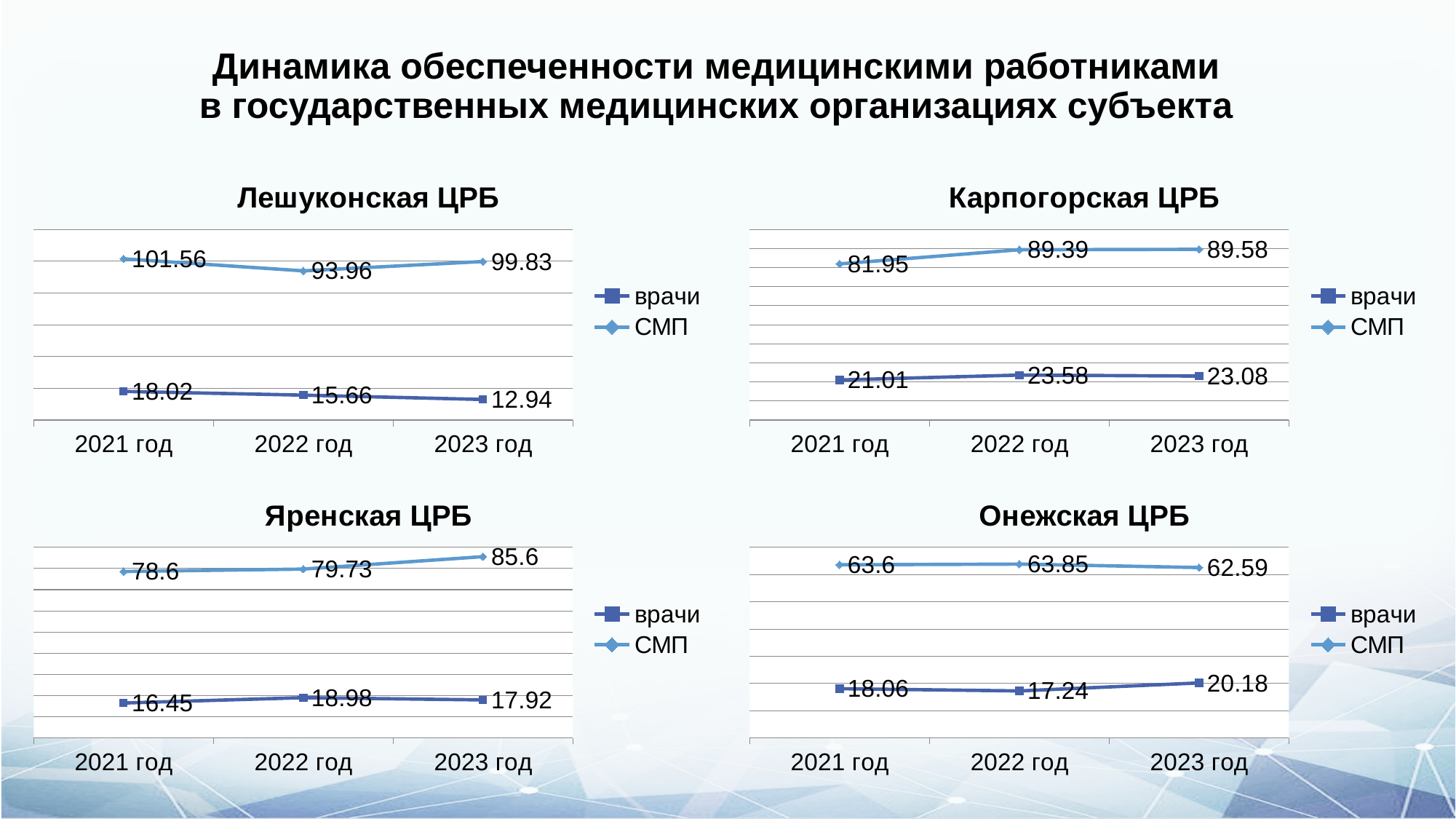
In the Яренская ЦРБ chart, what is the value for СМП in 2023 год? 85.6 In the Лешуконская ЦРБ chart, what is the value for СМП in 2021 год? 101.56 How many years are plotted on the x axis of the Онежская ЦРБ chart? 3 In the Лешуконская ЦРБ chart, do the врачи values rise or fall from 2021 год to 2023 год? fall In the Карпогорская ЦРБ chart, what is the difference between the врачи values for 2022 год and 2021 год? 2.57 In the Онежская ЦРБ chart, which is larger: the СМП value for 2021 год or for 2023 год? 2021 год In the Лешуконская ЦРБ chart, what is the value for врачи in 2023 год? 12.94 In the Карпогорская ЦРБ chart, which year has the highest value for СМП? 2023 год How many series does the legend of the Яренская ЦРБ chart list? 2 In the Онежская ЦРБ chart, what is the value for врачи in 2022 год? 17.24 In the Яренская ЦРБ chart, which year has the lowest value for врачи? 2021 год What kind of chart is the Карпогорская ЦРБ chart? line chart